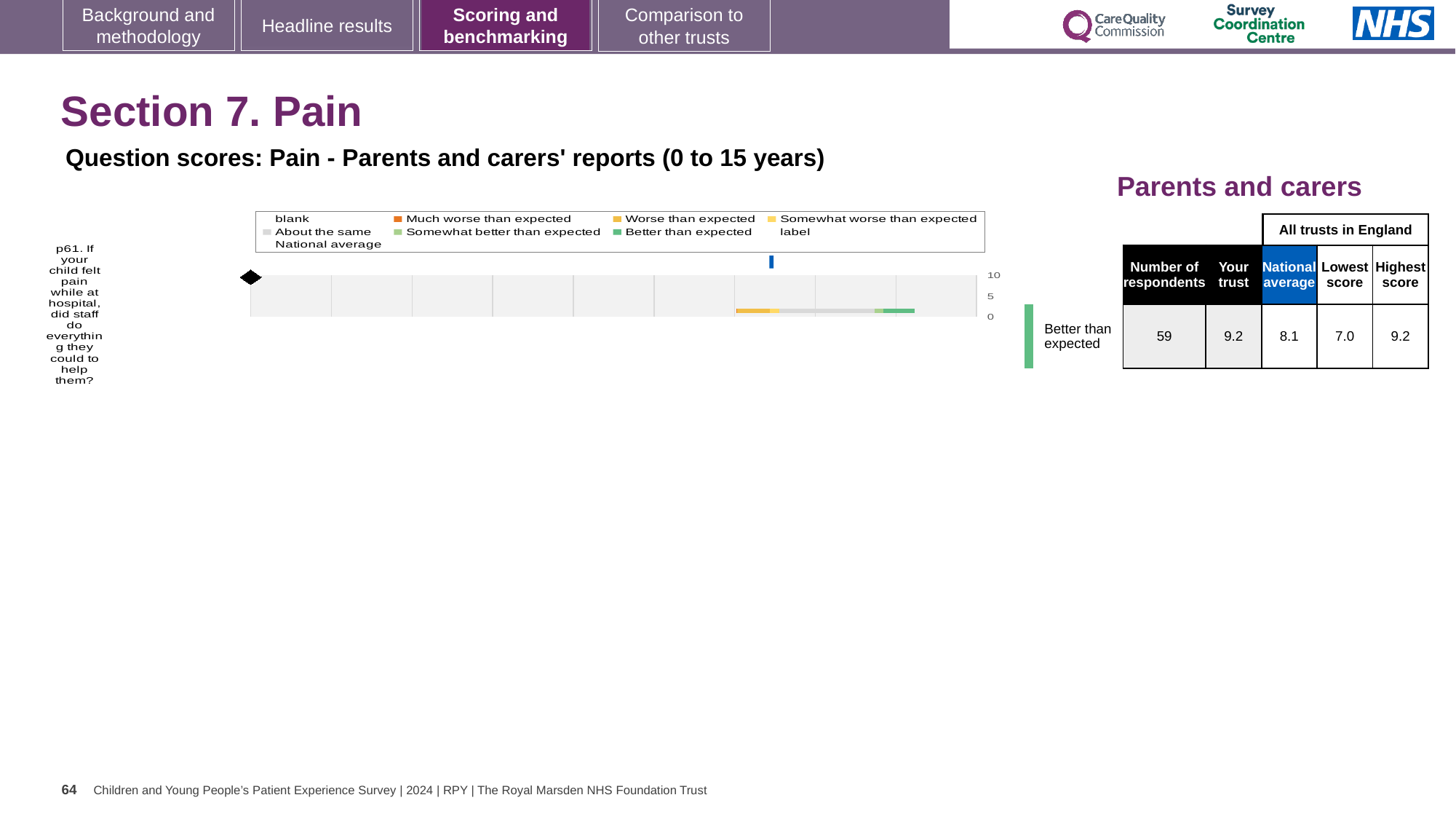
According to the table beside the chart, what is the National average score for question p61? 8.1 What kind of chart is shown on the slide? bar chart According to the table beside the chart, what is the score for Your trust on question p61? 9.2 According to the table beside the chart, what is the Lowest score among all trusts in England for question p61? 7.0 What is the difference between Your trust score and the National average for question p61, as shown in the table beside the chart? 1.1 Which is larger for question p61, Your trust score or the National average? Your trust According to the table beside the chart, how many respondents answered question p61? 59 What benchmark category is the trust's result for question p61 labelled as? Better than expected According to the table beside the chart, what is the Highest score among all trusts in England for question p61? 9.2 Which survey question is plotted in the chart? p61. If your child felt pain while at hospital, did staff do everything they could to help them? What is the highest value shown on the chart's axis? 10 How many survey questions are plotted in the chart? 1